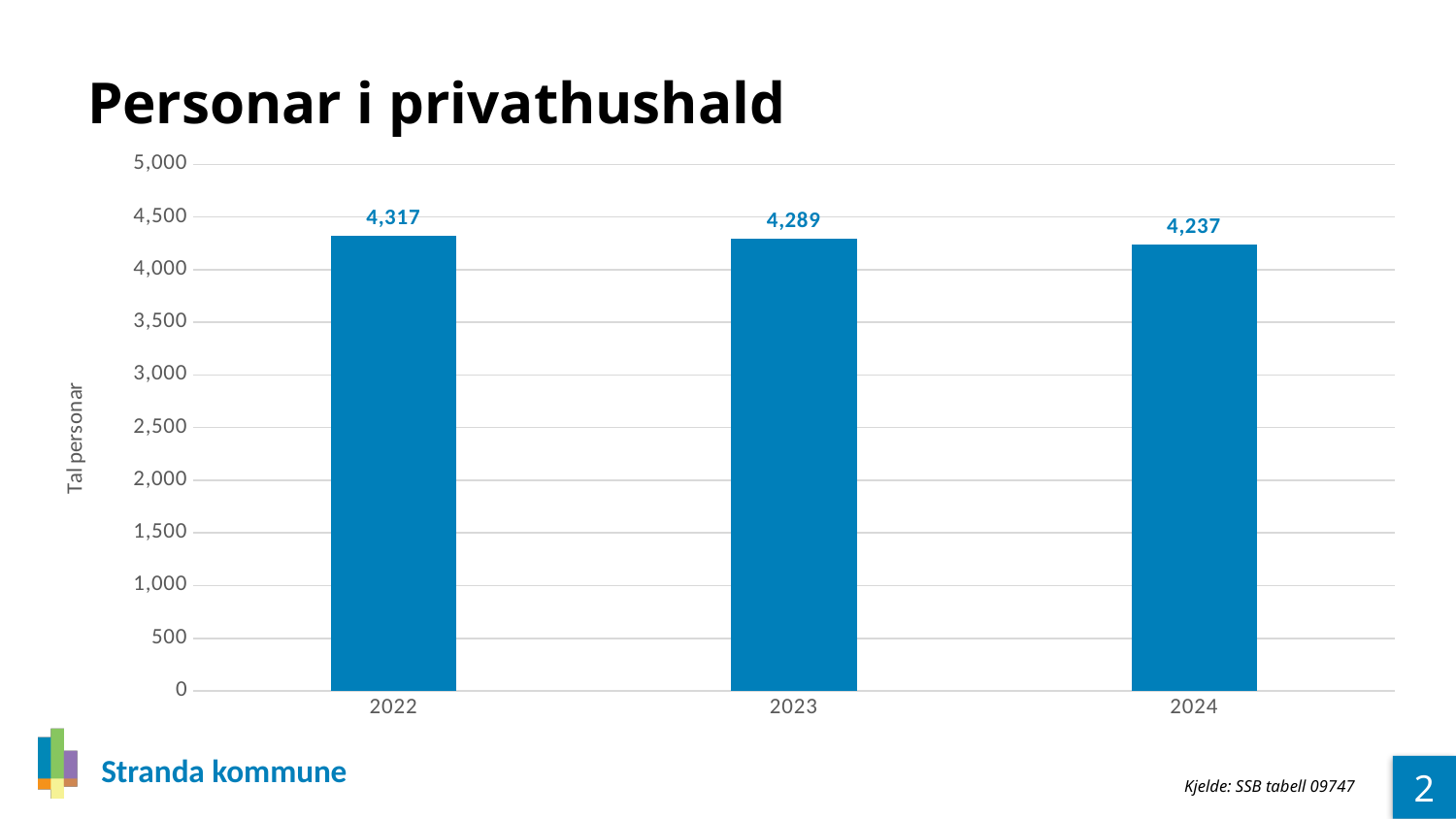
How many years are shown on the x axis? 3 Which is larger, the value for 2023 or the value for 2024? 2023 Is the value for 2024 greater or less than 4,000? greater Which year has the highest value? 2022 What is the value for 2022? 4,317 What is the value for 2024? 4,237 What is the value for 2023? 4,289 What kind of chart is shown on the slide? bar chart What is the difference between the values for 2022 and 2024? 80 What is the difference between the values for 2022 and 2023? 28 Do the values rise or fall from 2022 to 2024? fall Which year has the lowest value? 2024